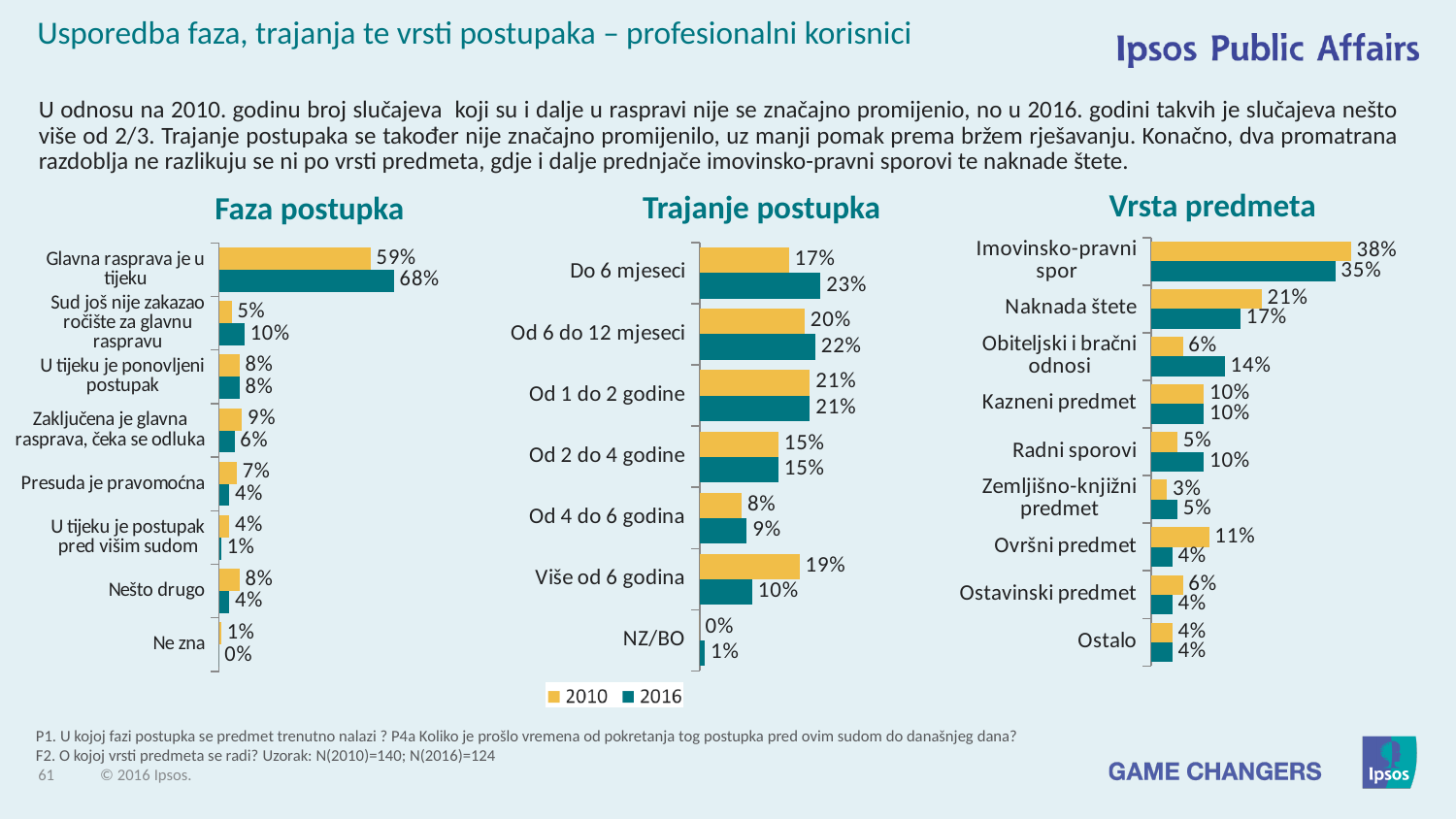
In the 'Faza postupka' chart, what is the 2016 value for 'Glavna rasprava je u tijeku'? 68% In the 'Vrsta predmeta' chart, what is the difference between the 2016 and 2010 values for 'Obiteljski i bračni odnosi'? 8 percentage points In the 'Trajanje postupka' chart, what is the 2016 value for 'Do 6 mjeseci'? 23% In the 'Faza postupka' chart, what is the difference between the 2016 and 2010 values for 'Glavna rasprava je u tijeku'? 9 percentage points In the 'Vrsta predmeta' chart, what is the 2010 value for 'Imovinsko-pravni spor'? 38% In the 'Faza postupka' chart, which category has the highest 2010 value? Glavna rasprava je u tijeku How many series does the legend list? 2 In the 'Trajanje postupka' chart, how many categories are shown on the axis? 7 In the 'Faza postupka' chart, what is the 2010 value for 'Sud još nije zakazao ročište za glavnu raspravu'? 5% What kind of chart is 'Trajanje postupka'? Bar chart In the 'Trajanje postupka' chart, which is larger for 'Više od 6 godina': the 2010 value or the 2016 value? 2010 In the 'Vrsta predmeta' chart, which category has the lowest 2016 value? Ovršni predmet, Ostavinski predmet and Ostalo (all 4%)